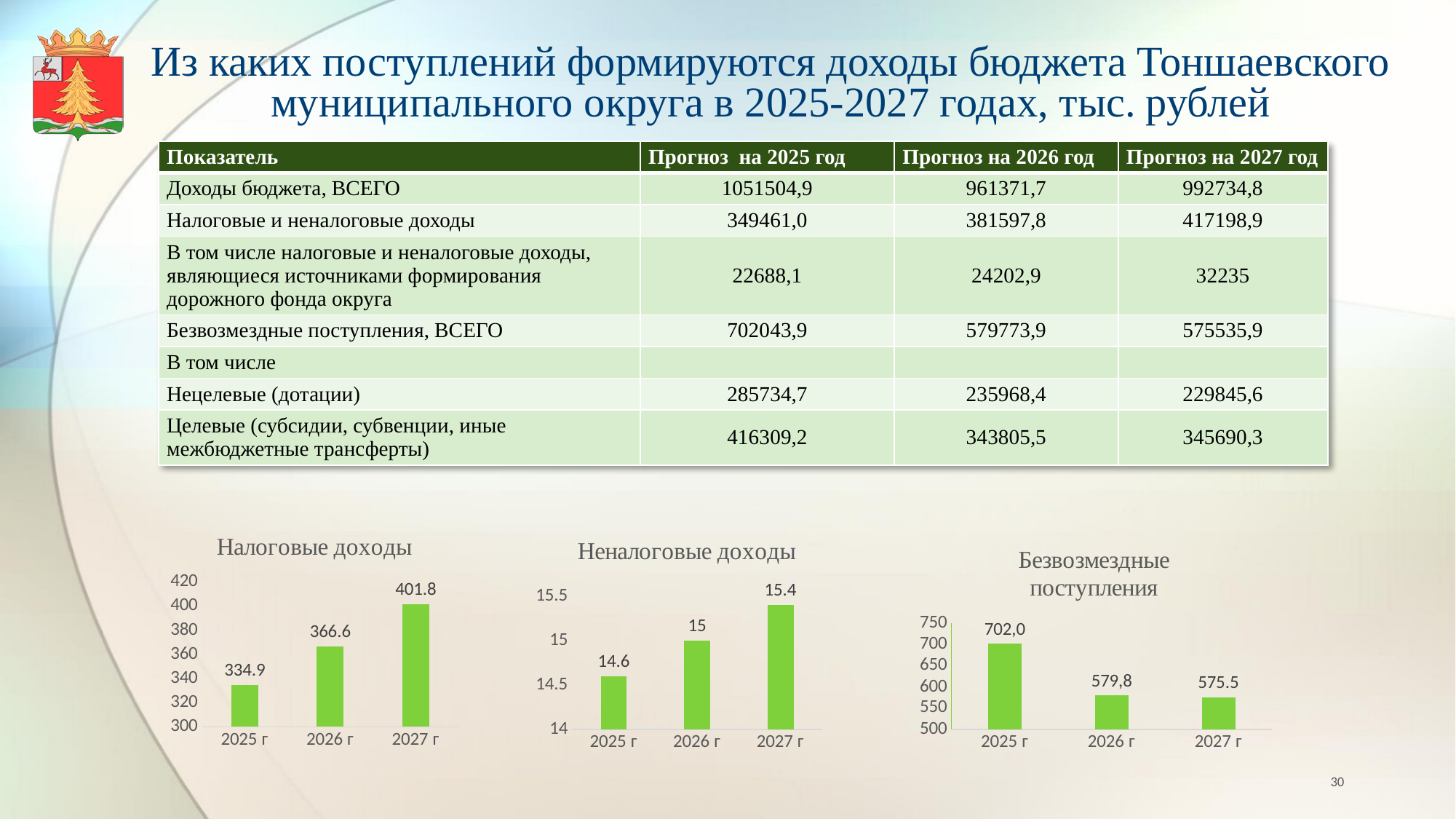
In the 'Налоговые доходы' chart, what is the difference between the 2027 г and 2025 г values? 66.9 In the 'Неналоговые доходы' chart, what is the value for 2026 г? 15 In the 'Безвозмездные поступления' chart, what is the value for 2025 г? 702,0 In the 'Налоговые доходы' chart, what is the value for 2027 г? 401.8 In the 'Неналоговые доходы' chart, do the values rise or fall from 2025 г to 2027 г? rise In the 'Безвозмездные поступления' chart, what is the value for 2027 г? 575.5 In the 'Налоговые доходы' chart, which year has the highest value? 2027 г What type of chart is the 'Налоговые доходы' chart? bar chart In the 'Налоговые доходы' chart, what is the value for 2025 г? 334.9 In the 'Безвозмездные поступления' chart, which is larger, the value for 2026 г or 2027 г? 2026 г In the 'Неналоговые доходы' chart, which year has the lowest value? 2025 г In the 'Безвозмездные поступления' chart, is the value for 2025 г greater or less than 650? greater